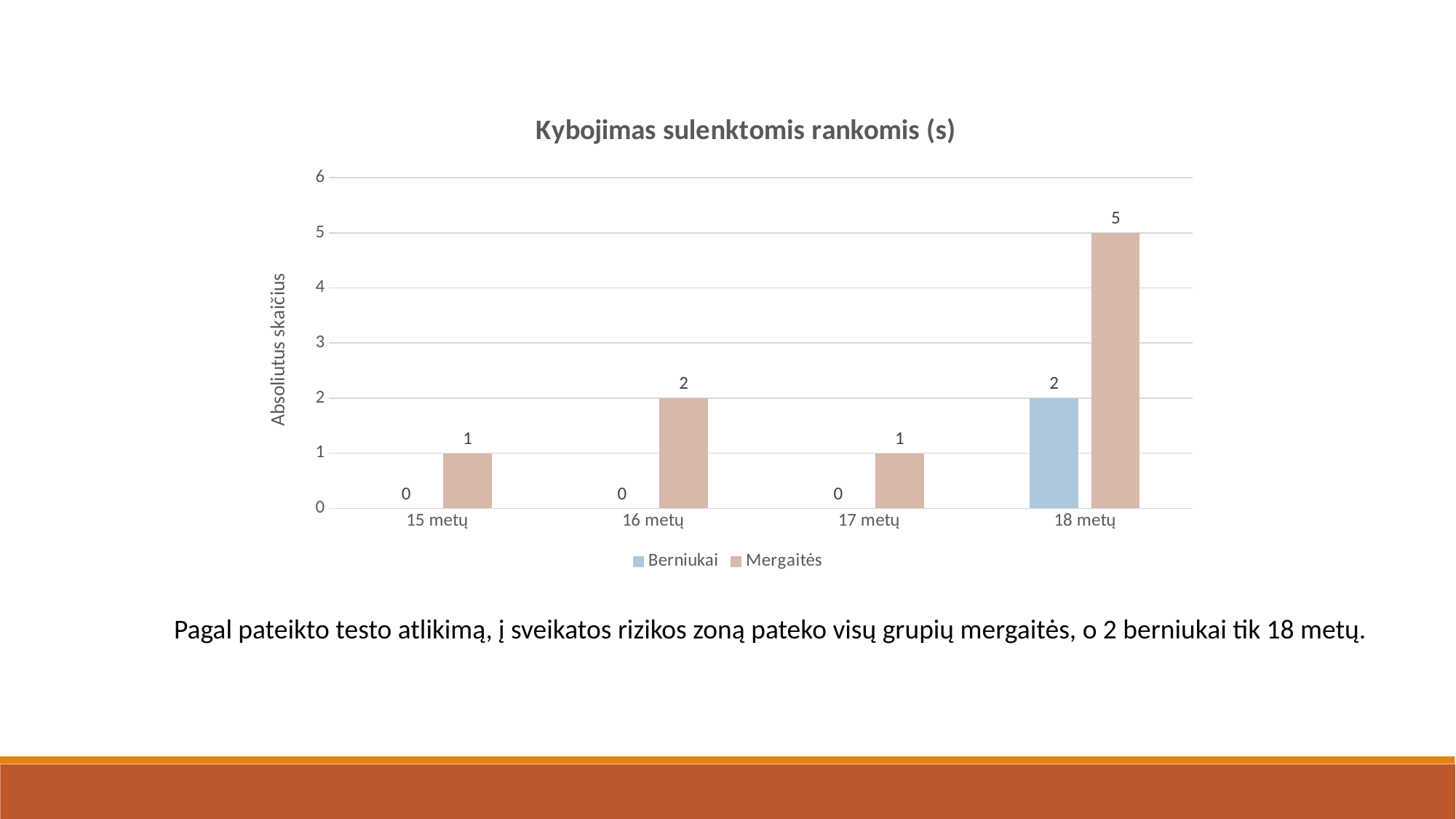
Which is larger at 17 metų, Berniukai or Mergaitės? Mergaitės Which age group has the highest value for Berniukai? 18 metų What is the value for Berniukai at 18 metų? 2 What is the value for Berniukai at 15 metų? 0 How many age groups are shown on the x axis? 4 How many series does the legend list? 2 Which age group has the highest value for Mergaitės? 18 metų What is the value for Mergaitės at 18 metų? 5 What is the difference between Mergaitės and Berniukai at 18 metų? 3 What is the title of the chart? Kybojimas sulenktomis rankomis (s) What kind of chart is shown? Bar chart What is the value for Mergaitės at 16 metų? 2